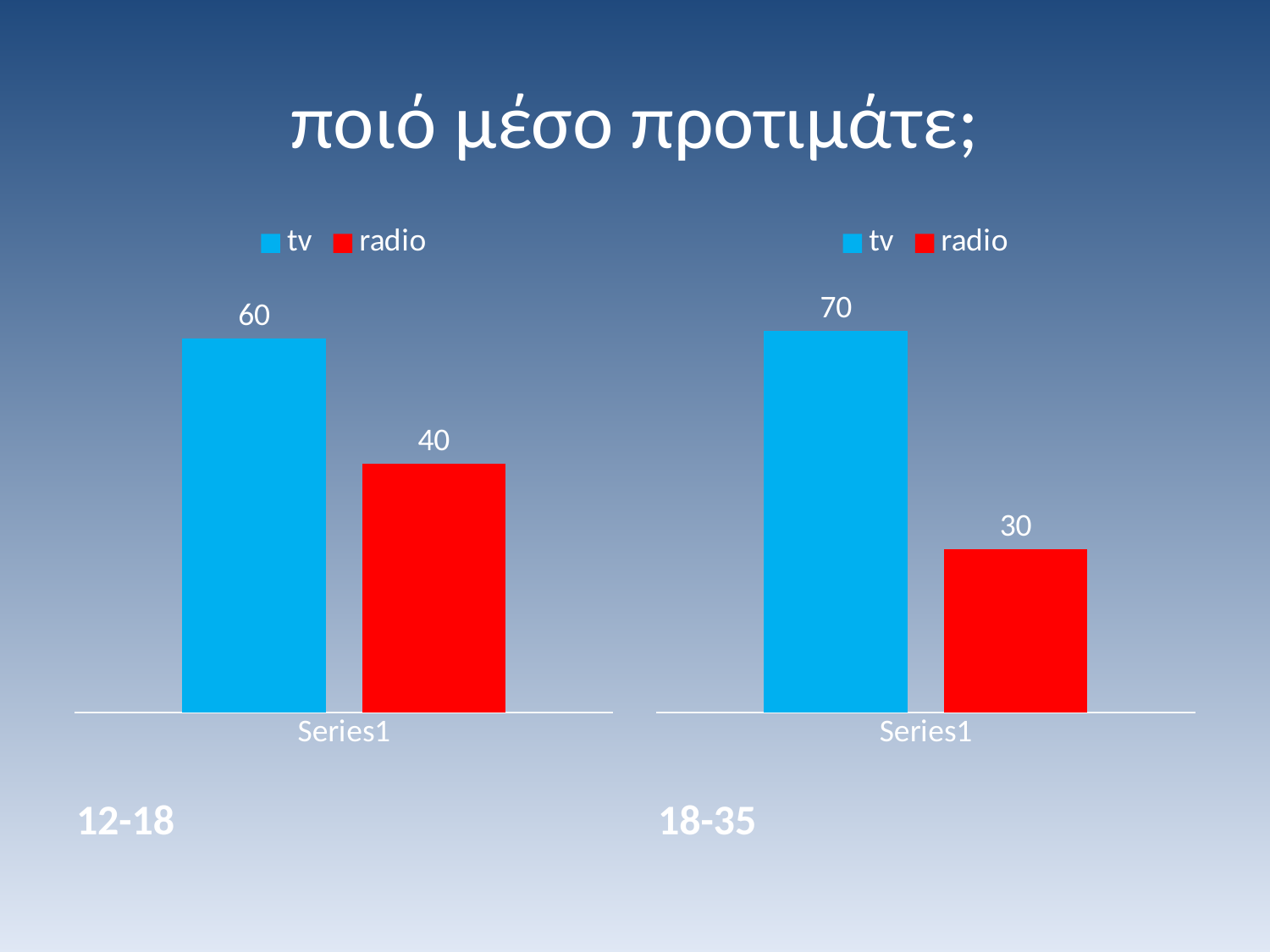
What is the title of the slide? ποιό μέσο προτιμάτε; In the right chart (18-35), what is the value for tv? 70 In the left chart (12-18), what is the difference between the tv and radio values? 20 How many series does the legend of the right chart (18-35) list? 2 In the right chart (18-35), what is the difference between the tv and radio values? 40 In the left chart (12-18), what is the value for radio? 40 In the left chart (12-18), what colour is the radio bar? red In the left chart (12-18), what is the value for tv? 60 In the right chart (18-35), what is the value for radio? 30 In the right chart (18-35), which series has the lowest value? radio What kind of chart is the left chart (12-18)? bar chart In the left chart (12-18), which series has the higher value, tv or radio? tv